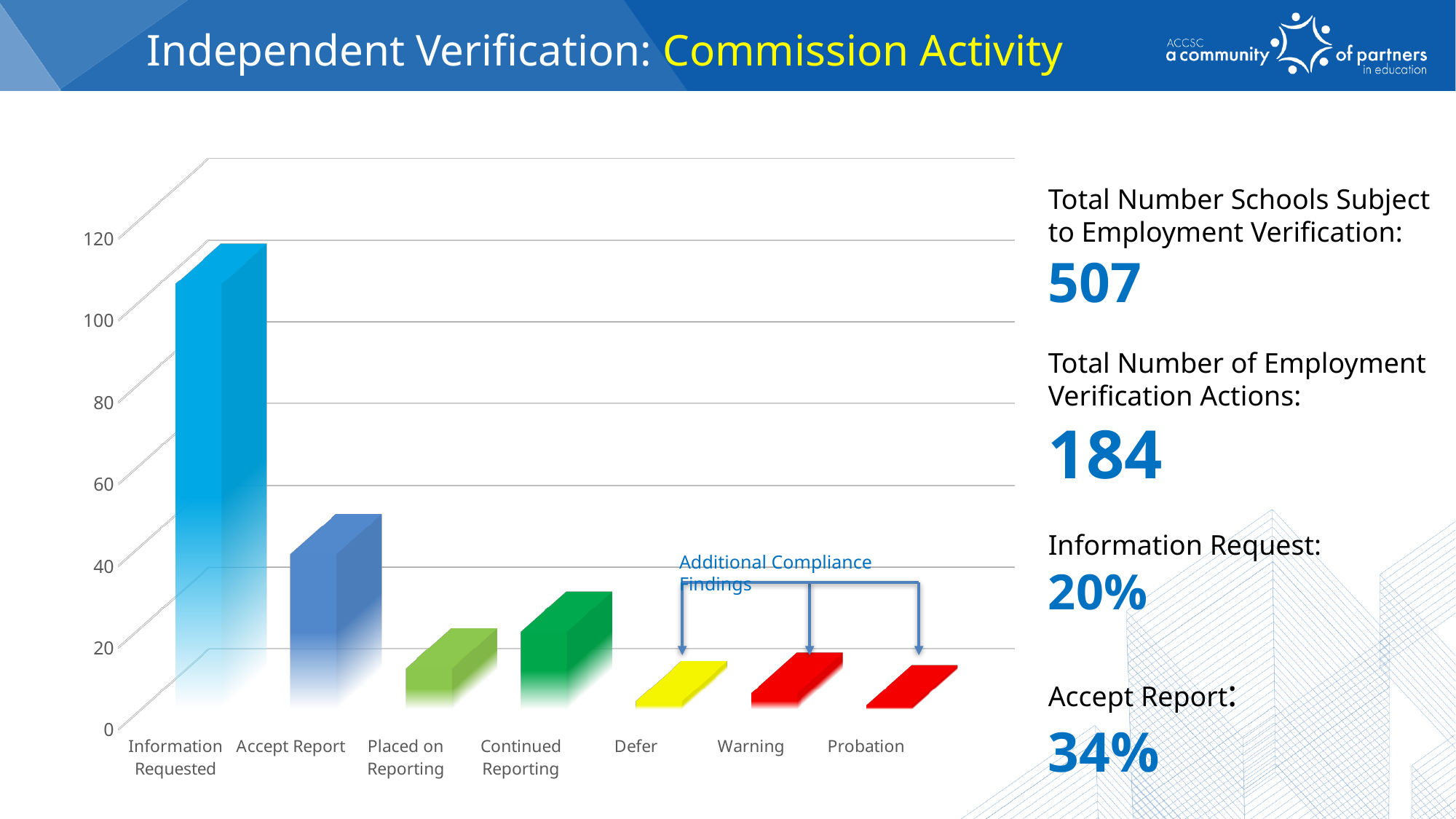
How many categories are shown on the x axis of the chart? 7 Is the value for Placed on Reporting greater or less than 20? less Is the value for Accept Report greater or less than 60? less What kind of chart is shown on the slide? bar chart Is the value for Defer greater or less than 20? less What colour are the Warning and Probation bars? red Which is larger, the value for Information Requested or the value for Accept Report? Information Requested Which is larger, the value for Continued Reporting or the value for Placed on Reporting? Continued Reporting Which three categories does the annotation 'Additional Compliance Findings' point to? Defer, Warning, Probation Which category has the highest value in the chart? Information Requested